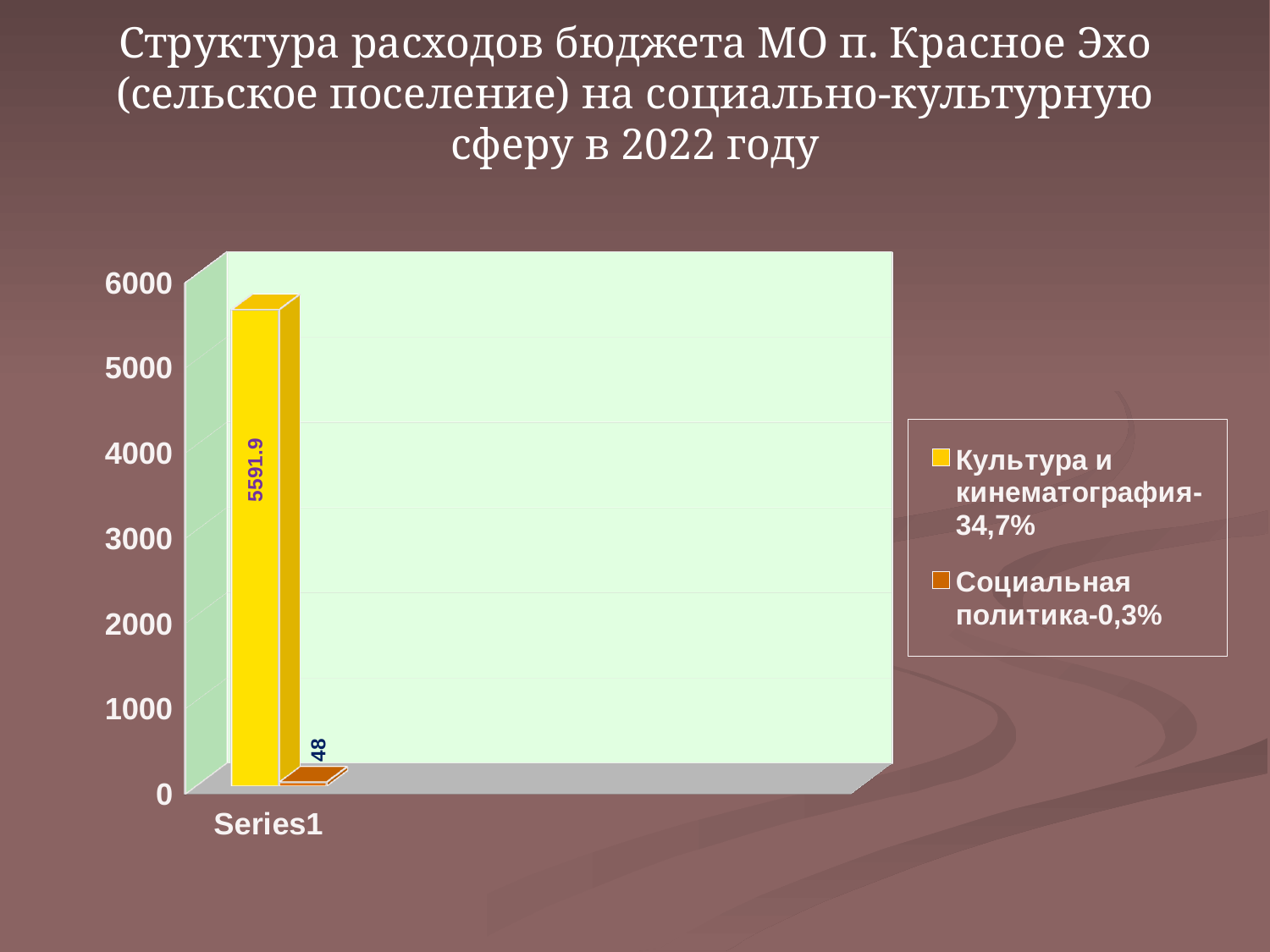
What is the value of the bar for Культура и кинематография? 5591.9 What percentage is shown in the legend entry for Социальная политика? 0,3% Which series has the higher value, Культура и кинематография or Социальная политика? Культура и кинематография Is the value for Социальная политика greater or less than 1000? less What is the label of the category on the x axis? Series1 What is the highest value shown on the vertical axis? 6000 What kind of chart is shown on the slide? bar chart What is the difference between the values for Культура и кинематография and Социальная политика? 5543.9 What is the value of the bar for Социальная политика? 48 Is the value for Культура и кинематография greater or less than 5000? greater Which series has the lowest value on the chart? Социальная политика How many series does the legend list? 2